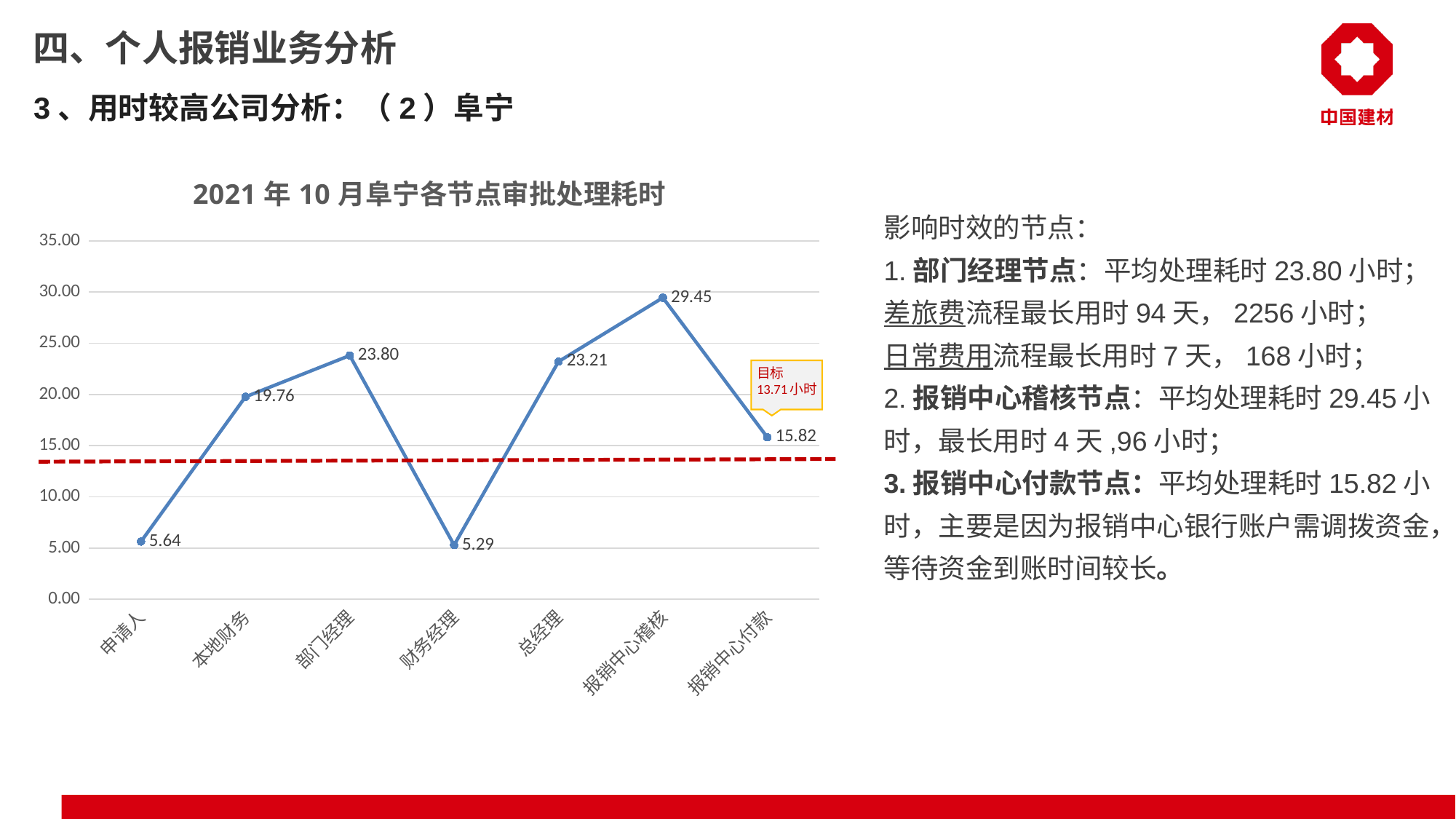
Is the value for 申请人 greater or less than 10.00? less What kind of chart is shown on the slide? line chart What is the difference between the values for 报销中心稽核 and 部门经理? 5.65 Which node has the lowest value in the chart? 财务经理 How many nodes (categories) are plotted on the x axis? 7 What is the value for 本地财务 in the chart? 19.76 What is the value for 报销中心付款 in the chart? 15.82 Which is larger, the value for 总经理 or the value for 本地财务? 总经理 Which node has the highest value in the chart? 报销中心稽核 What target value does the red dashed line in the chart represent? 13.71小时 What is the value for 部门经理 in the chart? 23.80 What is the title of the chart? 2021年10月阜宁各节点审批处理耗时